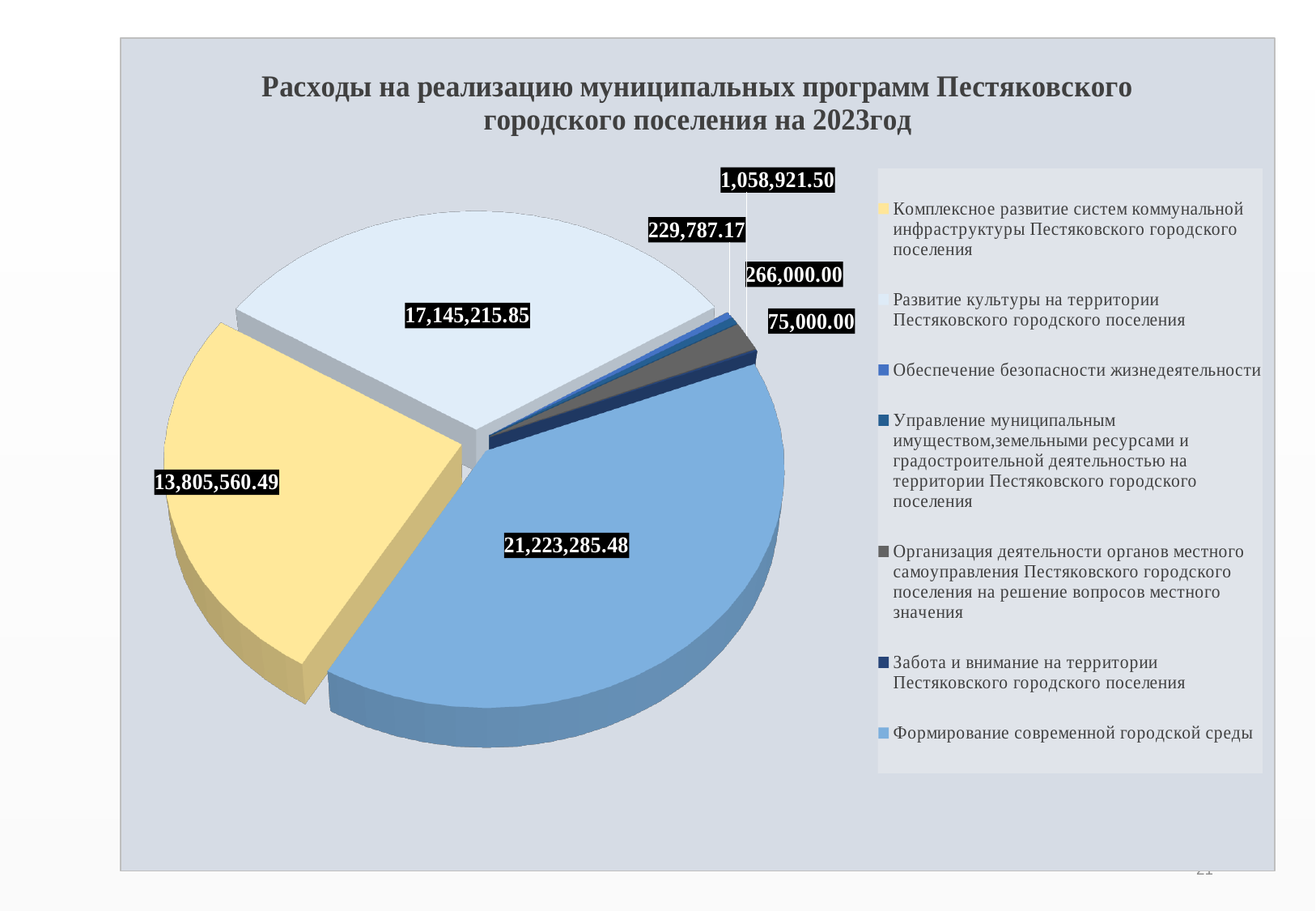
What is the value for Комплексное развитие систем коммунальной инфраструктуры Пестяковского городского поселения? 13,805,560.49 What colour is the slice for Комплексное развитие систем коммунальной инфраструктуры Пестяковского городского поселения? Yellow What is the value for Развитие культуры на территории Пестяковского городского поселения? 17,145,215.85 Which category has the largest slice of the pie? Формирование современной городской среды What is the smallest value labelled on the chart? 75,000.00 What is the value for Формирование современной городской среды? 21,223,285.48 What is the title of the chart? Расходы на реализацию муниципальных программ Пестяковского городского поселения на 2023год What is the difference between the values for Развитие культуры на территории Пестяковского городского поселения and Комплексное развитие систем коммунальной инфраструктуры Пестяковского городского поселения? 3,339,655.36 Which is larger: the value for Комплексное развитие систем коммунальной инфраструктуры or the value for Развитие культуры на территории Пестяковского городского поселения? Развитие культуры на территории Пестяковского городского поселения How many categories does the legend list? 7 What is the difference between the values for Формирование современной городской среды and Развитие культуры на территории Пестяковского городского поселения? 4,078,069.63 What type of chart is shown on the slide? Pie chart